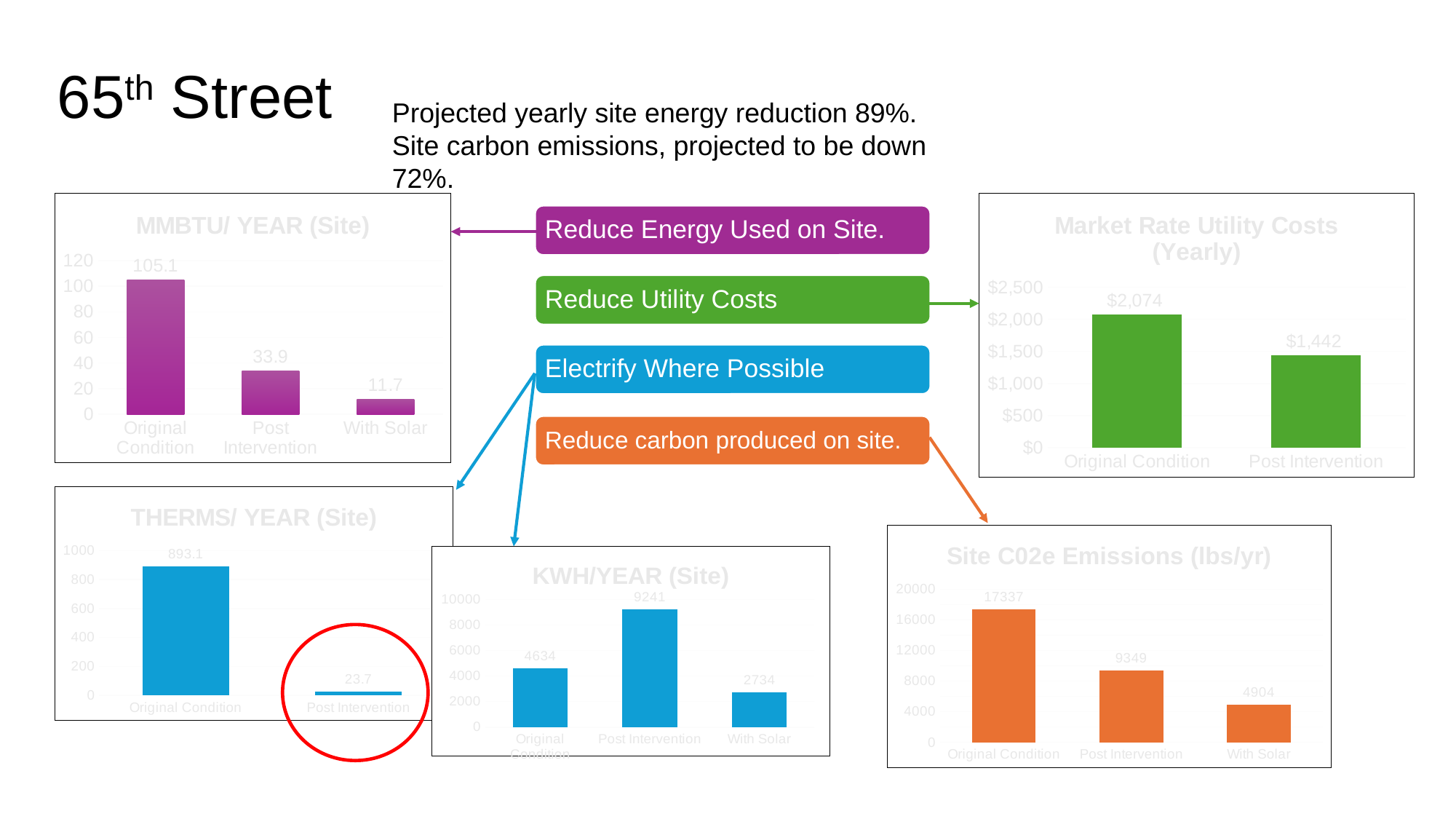
In the Site C02e Emissions (lbs/yr) chart, do the values rise or fall from Original Condition to With Solar? fall In the Market Rate Utility Costs (Yearly) chart, what is the value for Post Intervention? $1,442 In the MMBTU/ YEAR (Site) chart, what is the value for Original Condition? 105.1 In the Site C02e Emissions (lbs/yr) chart, what is the value for Original Condition? 17337 In the MMBTU/ YEAR (Site) chart, which category has the lowest value? With Solar In the Site C02e Emissions (lbs/yr) chart, what is the difference between Post Intervention and With Solar? 4445 What kind of chart is the KWH/YEAR (Site) chart? bar chart In the KWH/YEAR (Site) chart, what is the value for With Solar? 2734 In the Market Rate Utility Costs (Yearly) chart, what is the difference between Original Condition and Post Intervention? $632 In the THERMS/ YEAR (Site) chart, what is the value for Post Intervention? 23.7 In the KWH/YEAR (Site) chart, which category has the highest value? Post Intervention In the THERMS/ YEAR (Site) chart, how many categories are shown? 2